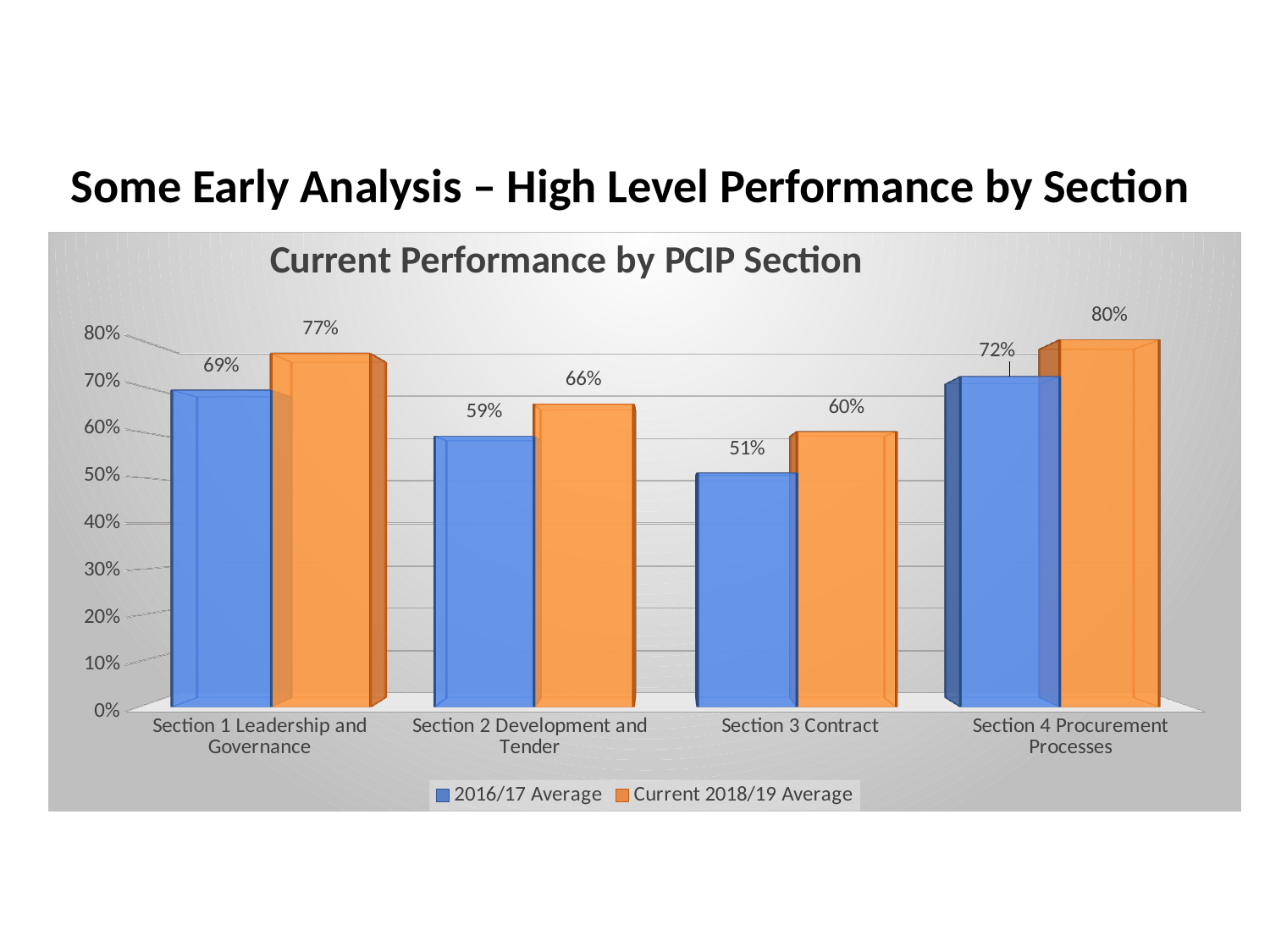
What is the difference between the Current 2018/19 Average and the 2016/17 Average for Section 3 Contract? 9% How many sections are shown on the x axis? 4 How many series does the legend list? 2 What is the title of the chart? Current Performance by PCIP Section What kind of chart is shown on the slide? Bar chart What is the Current 2018/19 Average value for Section 2 Development and Tender? 66% Which section has the highest Current 2018/19 Average? Section 4 Procurement Processes What is the difference between the Current 2018/19 Average and the 2016/17 Average for Section 1 Leadership and Governance? 8% What is the Current 2018/19 Average value for Section 3 Contract? 60% What is the 2016/17 Average value for Section 1 Leadership and Governance? 69% Which section has the lowest 2016/17 Average? Section 3 Contract Which is larger: the 2016/17 Average for Section 4 Procurement Processes or the Current 2018/19 Average for Section 2 Development and Tender? 2016/17 Average for Section 4 Procurement Processes